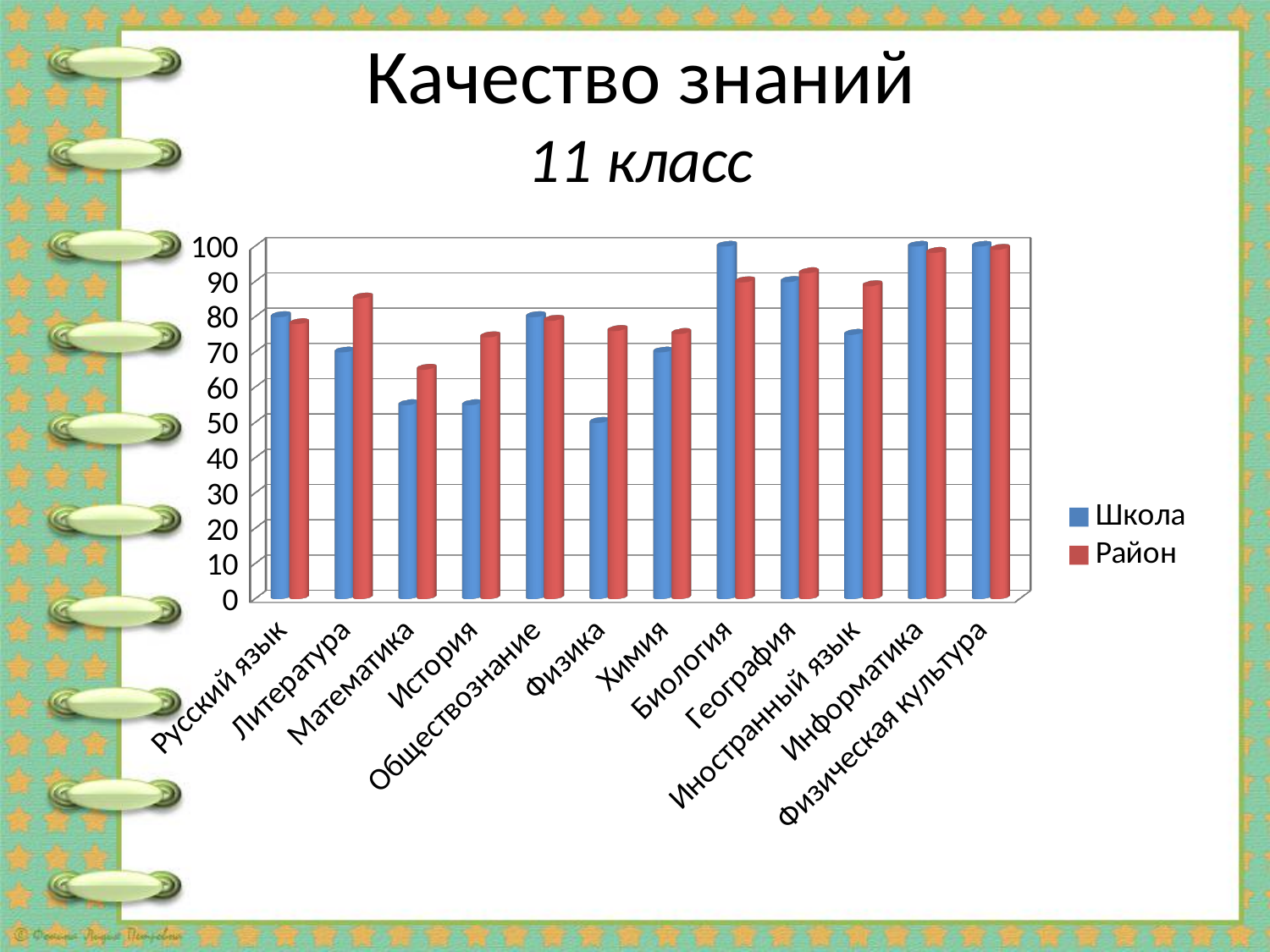
How many series does the chart legend list? 2 What is the value for Школа in Биология? 100 How many subjects (categories) are shown on the x axis of the chart? 12 In Биология, which is larger: the value for Школа or for Район? Школа What are the two series named in the chart legend? Школа and Район Is the value for Район in Иностранный язык greater or less than 80? greater What is the value for Школа in Информатика? 100 Which subject has the lowest value for Школа? Физика In Литература, which is larger: the value for Школа or for Район? Район Is the value for Школа in Физика greater or less than 60? less Which subject has the lowest value for Район? Математика What kind of chart is shown on the slide? bar chart